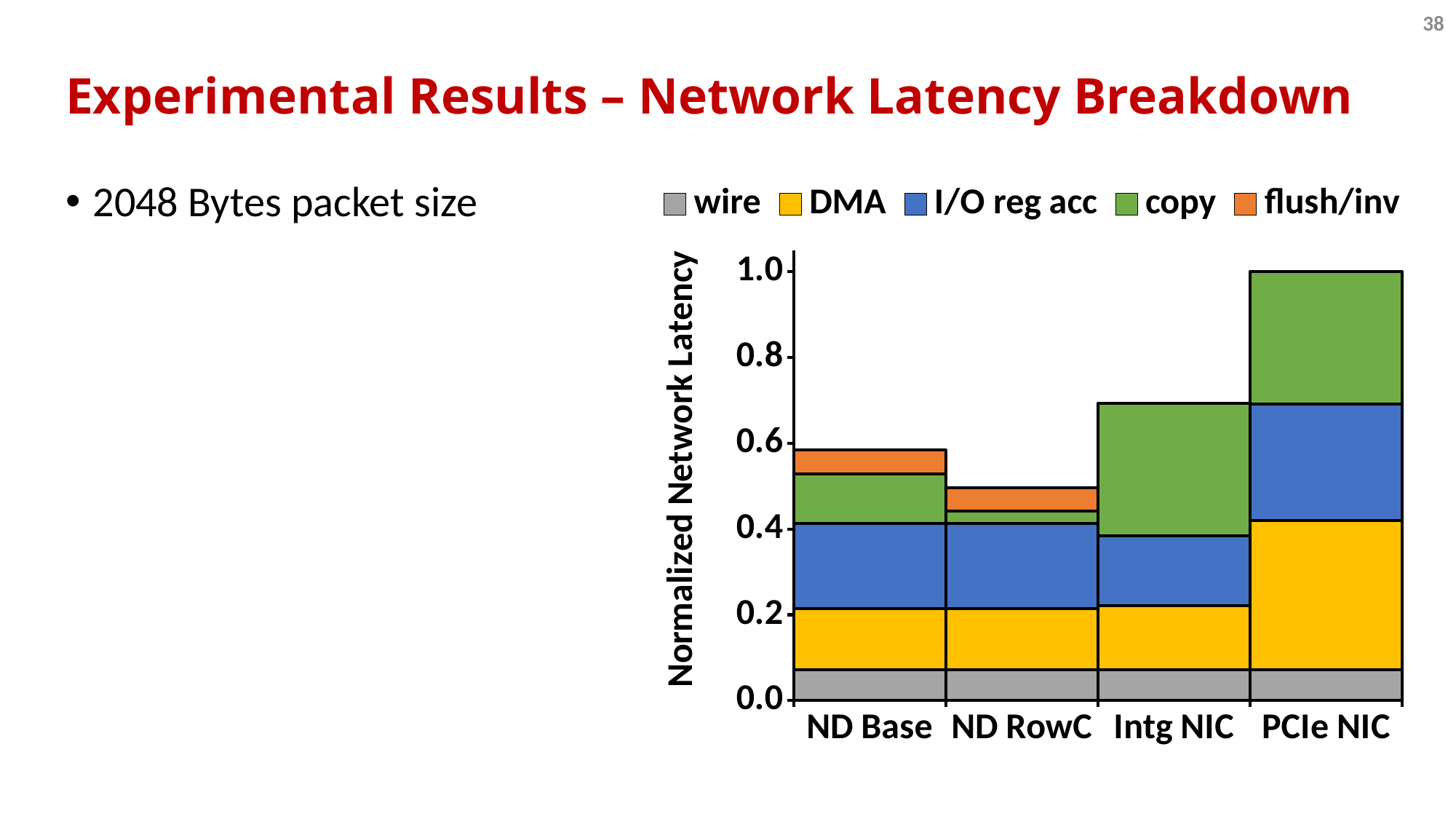
Which has a larger total normalized network latency, Intg NIC or ND Base? Intg NIC Is the total normalized network latency for ND Base greater or less than 0.4? greater What is the label of the y axis of the chart? Normalized Network Latency Is the total normalized network latency for ND RowC greater or less than 0.6? less Which category has the lowest total normalized network latency? ND RowC Which series is shown in green in the chart's legend? copy How many categories are shown on the x axis of the chart? 4 What kind of chart is shown on the slide? Stacked bar chart How many series does the chart's legend list? 5 Is the total normalized network latency for Intg NIC greater or less than 0.6? greater What is the total normalized network latency for PCIe NIC? 1.0 Which category has the highest total normalized network latency? PCIe NIC